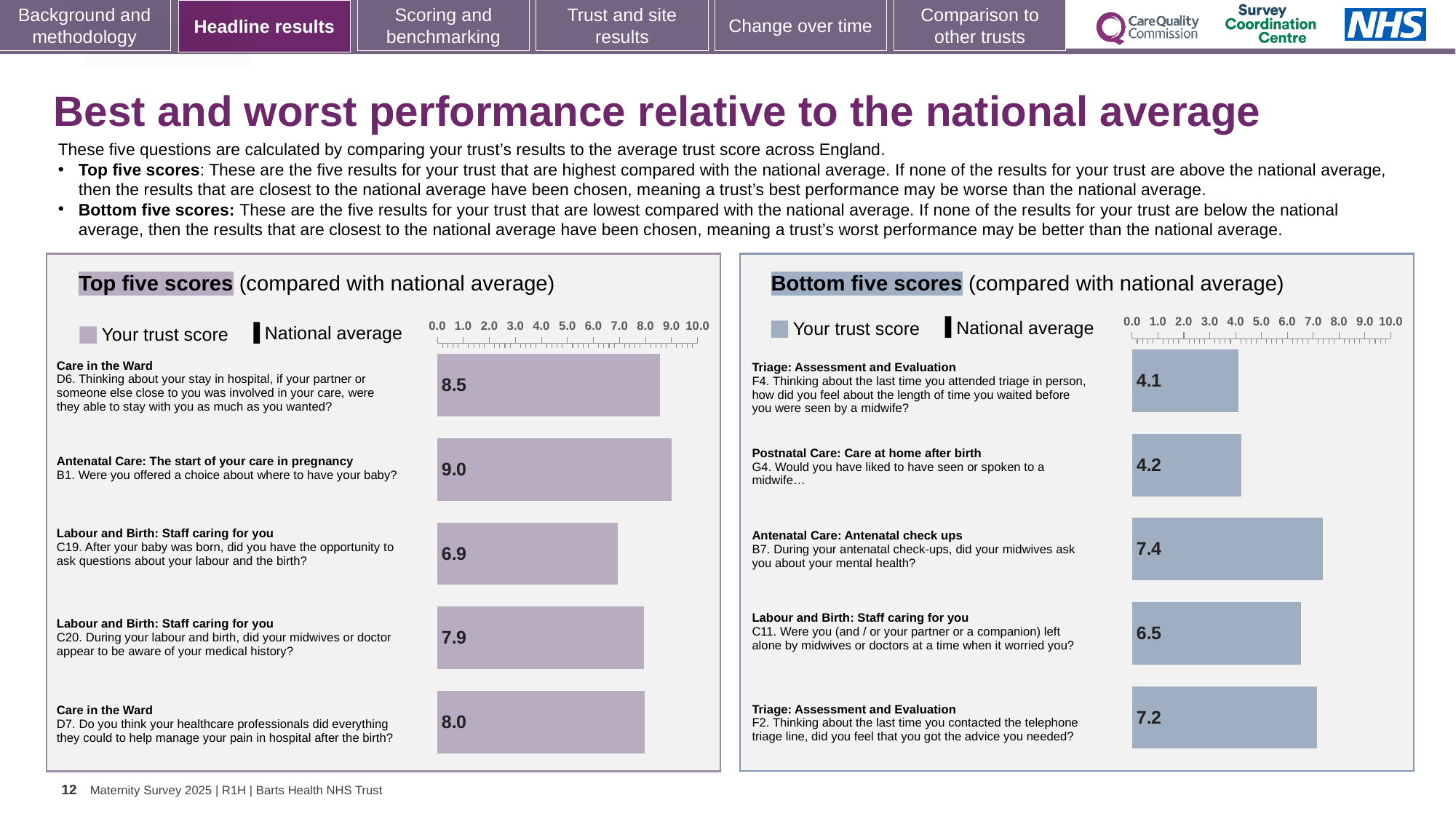
In the Top five scores chart, is the value for D6 greater or less than 8.0? greater In the Top five scores chart, what is the difference between the scores for B1 and C19? 2.1 What kind of chart is the Top five scores chart? Bar chart In the Top five scores chart, what is the trust score for C20 (were midwives or doctor aware of your medical history)? 7.9 In the Bottom five scores chart, what is the trust score for F2 (did you feel that you got the advice you needed from the telephone triage line)? 7.2 In the Bottom five scores chart, which has the larger trust score: B7 or C11? B7 In the Bottom five scores chart, what is the difference between the scores for B7 and F4? 3.3 How many series does the legend of the Top five scores chart list? 2 In the Top five scores chart, what is the trust score for B1 (Were you offered a choice about where to have your baby?)? 9.0 In the Bottom five scores chart, which question has the lowest trust score? F4 (Triage: Assessment and Evaluation) How many bars are shown in the Bottom five scores chart? 5 In the Top five scores chart, which question has the highest trust score? B1 (Antenatal Care: The start of your care in pregnancy)